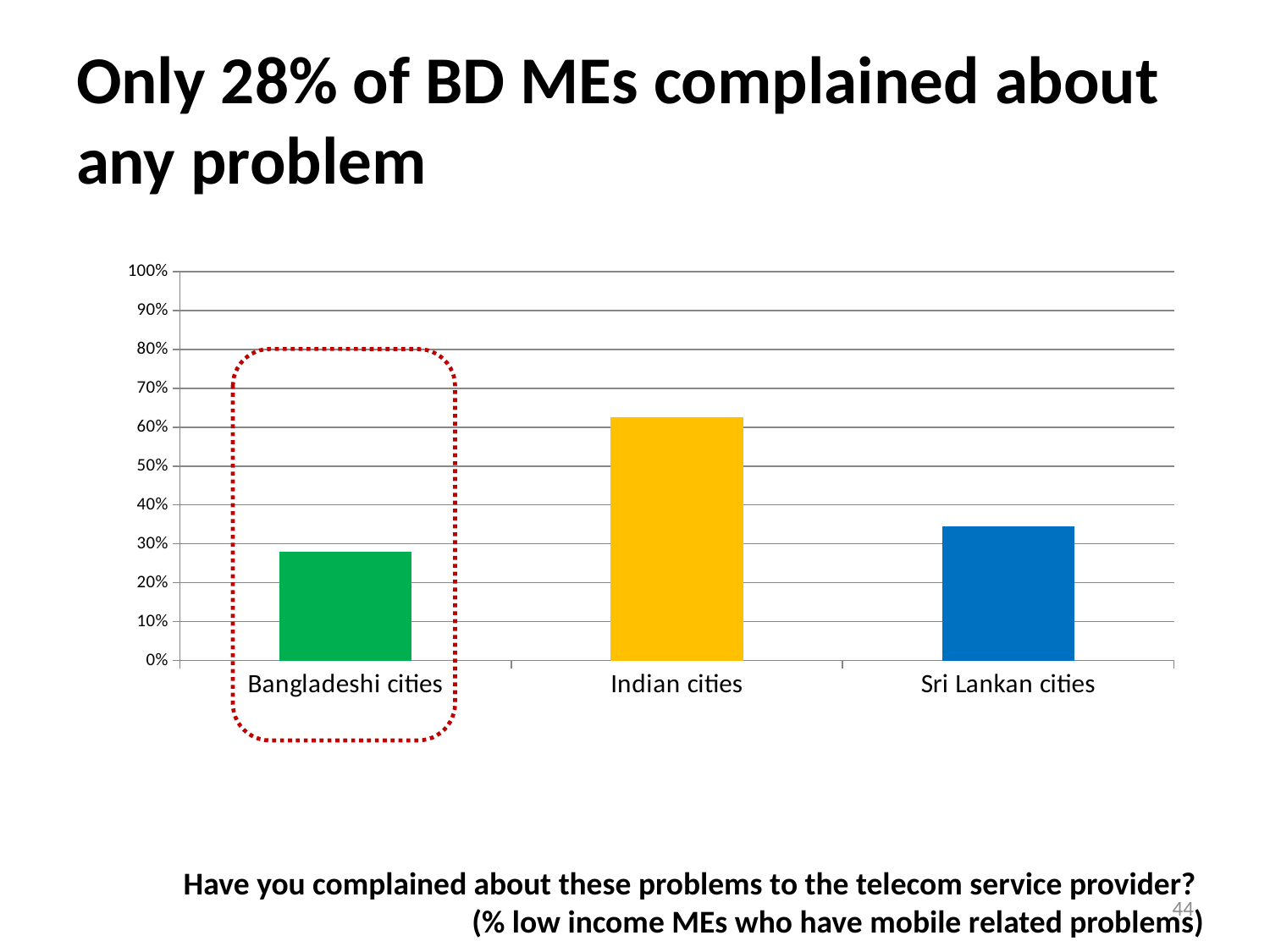
How many categories are plotted on the chart? 3 Is the value for Bangladeshi cities greater or less than 30%? less Which is larger, the value for Sri Lankan cities or the value for Bangladeshi cities? Sri Lankan cities Is the value for Sri Lankan cities greater or less than 40%? less Which category has the lowest value on the chart? Bangladeshi cities Is the value for Indian cities greater or less than 50%? greater According to the slide, what percentage of Bangladeshi MEs complained about any problem? 28% Which category has the highest value on the chart? Indian cities Which is larger, the value for Indian cities or the value for Sri Lankan cities? Indian cities Which category's bar is enclosed by the red dotted outline? Bangladeshi cities What kind of chart is shown on the slide? bar chart